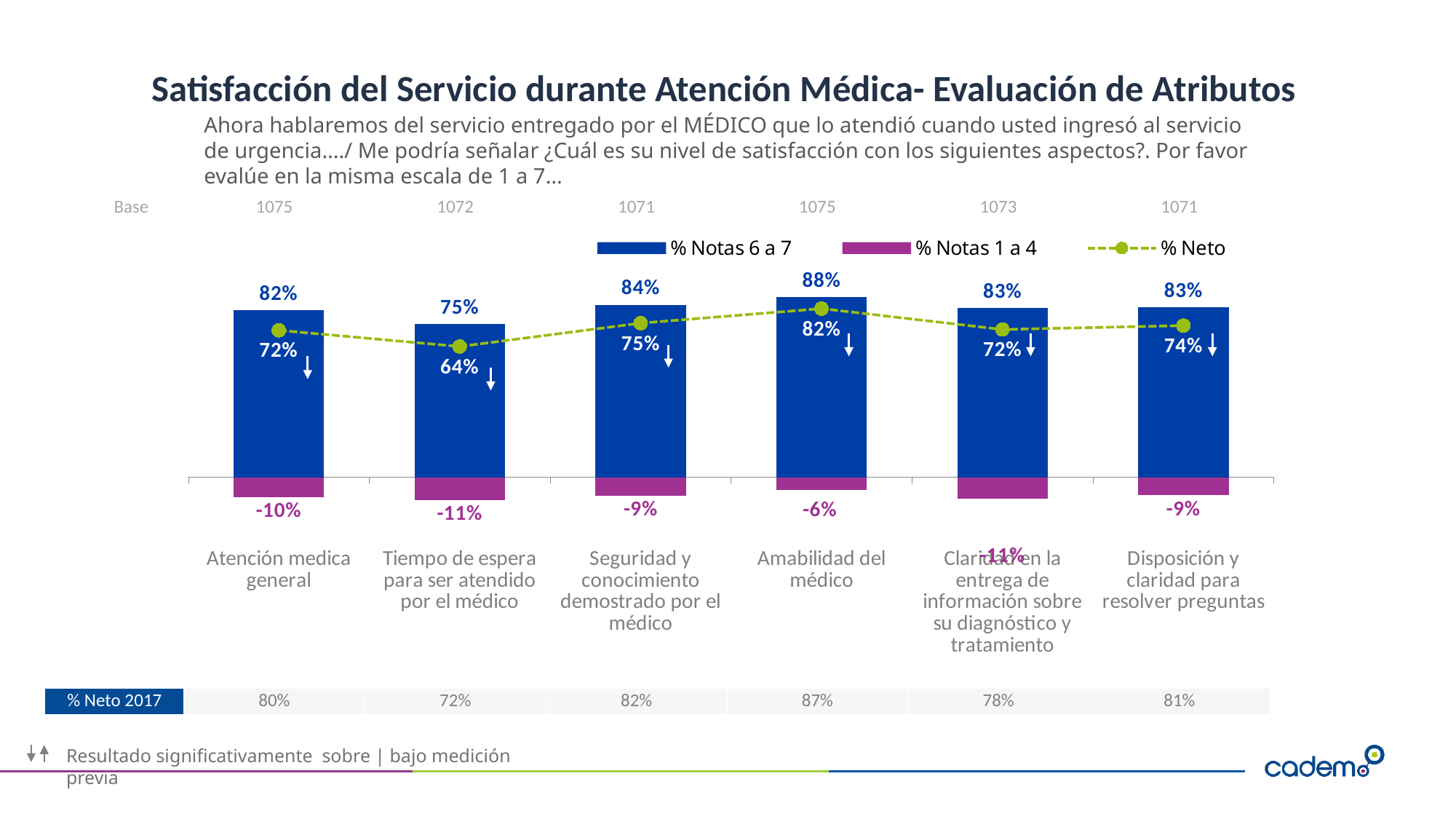
What is the % Notas 6 a 7 value for Amabilidad del médico? 88% What is the base (Base) shown for Tiempo de espera para ser atendido por el médico? 1072 What is the difference between the % Notas 6 a 7 values for Amabilidad del médico and Tiempo de espera para ser atendido por el médico? 13% How many categories are shown on the x axis of the chart? 6 Which category has the lowest % Neto value? Tiempo de espera para ser atendido por el médico What kind of chart is shown on the slide? Bar chart with a line Which category has the highest % Notas 6 a 7 value? Amabilidad del médico How many series does the chart legend list? 3 What is the % Neto value for Tiempo de espera para ser atendido por el médico? 64% What is the % Notas 1 a 4 value for Seguridad y conocimiento demostrado por el médico? -9% Which has a higher % Neto value: Atención medica general or Disposición y claridad para resolver preguntas? Disposición y claridad para resolver preguntas What is the % Neto 2017 value shown for Amabilidad del médico? 87%